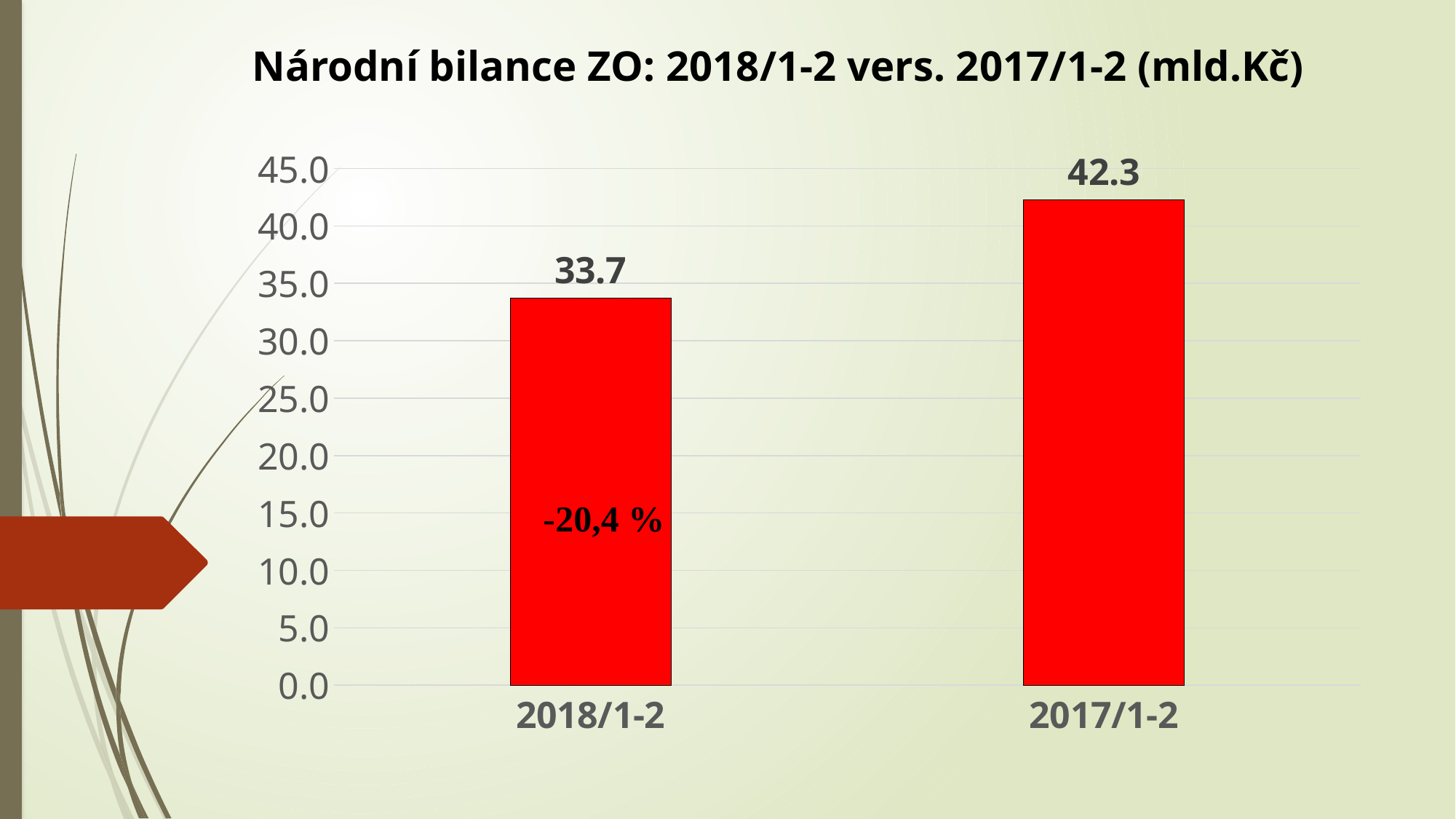
What percentage change is printed inside the 2018/1-2 bar? -20,4 % Which category has the highest value? 2017/1-2 Which category has the lowest value? 2018/1-2 What is the value for 2018/1-2? 33.7 Is the value for 2018/1-2 greater or less than 35.0? less Which is larger, the value for 2018/1-2 or the value for 2017/1-2? 2017/1-2 Is the value for 2017/1-2 greater or less than 40.0? greater What is the difference between the values for 2017/1-2 and 2018/1-2? 8.6 What is the title of the chart? Národní bilance ZO: 2018/1-2 vers. 2017/1-2 (mld.Kč) What is the value for 2017/1-2? 42.3 How many categories are shown on the chart? 2 What kind of chart is shown on the slide? bar chart